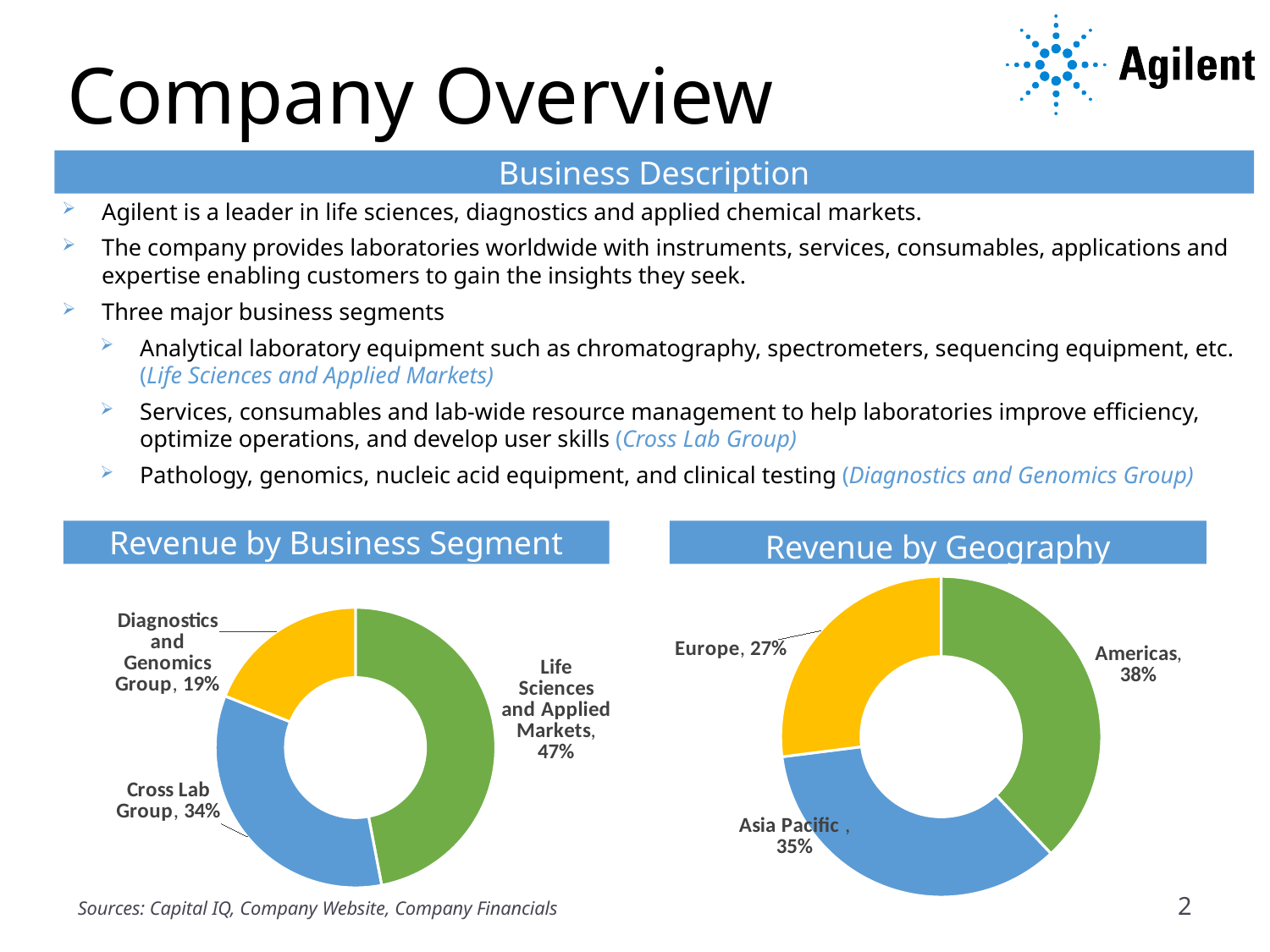
In the Revenue by Geography chart, what share of revenue comes from the Americas? 38% What type of chart is used for Revenue by Business Segment? Doughnut (pie) chart In the Revenue by Business Segment chart, what is the difference in percentage points between the Life Sciences and Applied Markets share and the Diagnostics and Genomics Group share? 28 percentage points How many regions are shown in the Revenue by Geography chart? 3 In the Revenue by Business Segment chart, which segment has the smallest share of revenue? Diagnostics and Genomics Group In the Revenue by Geography chart, what is the difference in percentage points between the Asia Pacific share and the Europe share? 8 percentage points In the Revenue by Geography chart, which region has the smallest share of revenue? Europe In the Revenue by Business Segment chart, what share of revenue comes from the Cross Lab Group? 34% In the Revenue by Business Segment chart, which segment has the largest share of revenue? Life Sciences and Applied Markets In the Revenue by Business Segment chart, what share of revenue comes from the Life Sciences and Applied Markets segment? 47% In the Revenue by Geography chart, which is larger, the Americas share or the Asia Pacific share? Americas In the Revenue by Geography chart, what share of revenue comes from Europe? 27%